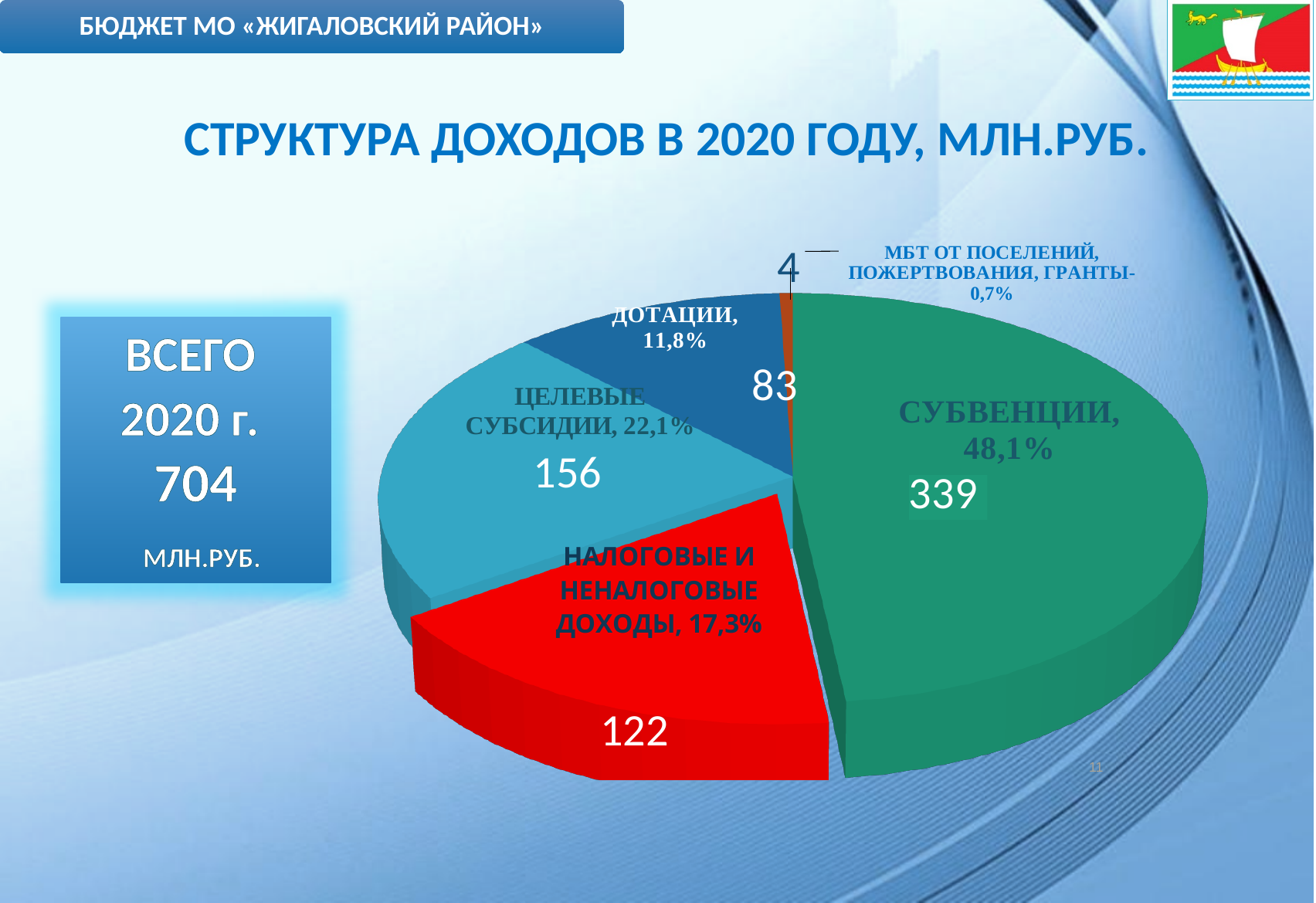
Which is larger, ЦЕЛЕВЫЕ СУБСИДИИ or НАЛОГОВЫЕ И НЕНАЛОГОВЫЕ ДОХОДЫ? ЦЕЛЕВЫЕ СУБСИДИИ What is the value for ЦЕЛЕВЫЕ СУБСИДИИ? 156 How many slices does the pie chart have? 5 Which category has the largest slice? СУБВЕНЦИИ What is the value for СУБВЕНЦИИ? 339 What is the difference between the values for СУБВЕНЦИИ and ЦЕЛЕВЫЕ СУБСИДИИ? 183 What kind of chart is shown on the slide? pie chart What share of the pie does СУБВЕНЦИИ represent? 48,1% What is the value for НАЛОГОВЫЕ И НЕНАЛОГОВЫЕ ДОХОДЫ? 122 What share of the pie does ДОТАЦИИ represent? 11,8% What is the value for ДОТАЦИИ? 83 Which category has the smallest slice? МБТ ОТ ПОСЕЛЕНИЙ, ПОЖЕРТВОВАНИЯ, ГРАНТЫ